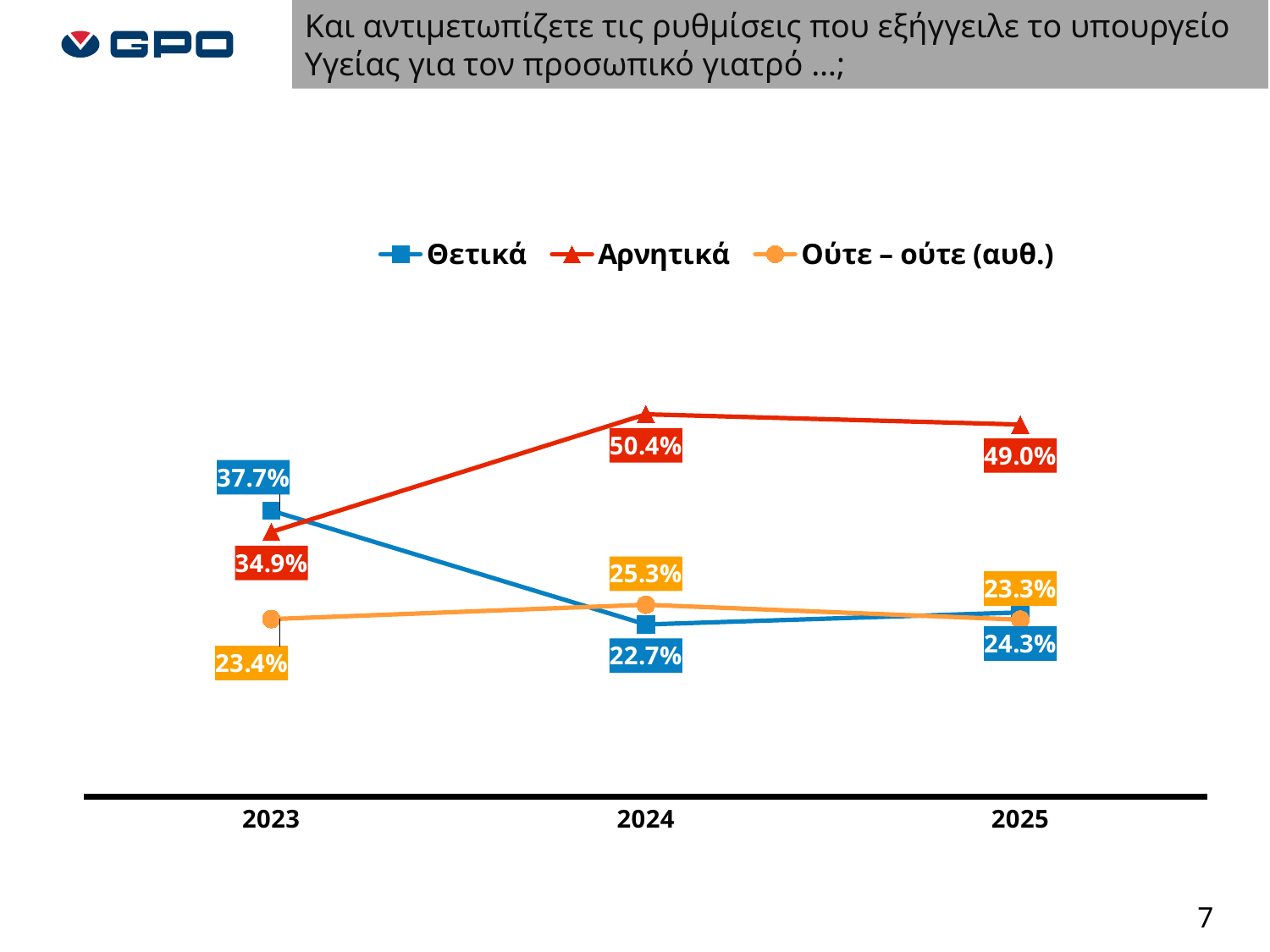
How many series does the legend list? 3 In which year is the Θετικά value lowest? 2024 What is the value for Αρνητικά in 2024? 50.4% Which series is shown with a red line and triangle markers? Αρνητικά What type of chart is shown on the slide? line chart Which is larger in 2023, Θετικά or Αρνητικά? Θετικά What is the value for Θετικά in 2023? 37.7% In which year is the Αρνητικά value highest? 2024 How does the Θετικά series change from 2023 to 2024? It falls What is the value for Ούτε – ούτε (αυθ.) in 2025? 23.3% What is the difference between the Αρνητικά and Θετικά values in 2025? 24.7 percentage points How many years are shown on the x axis? 3